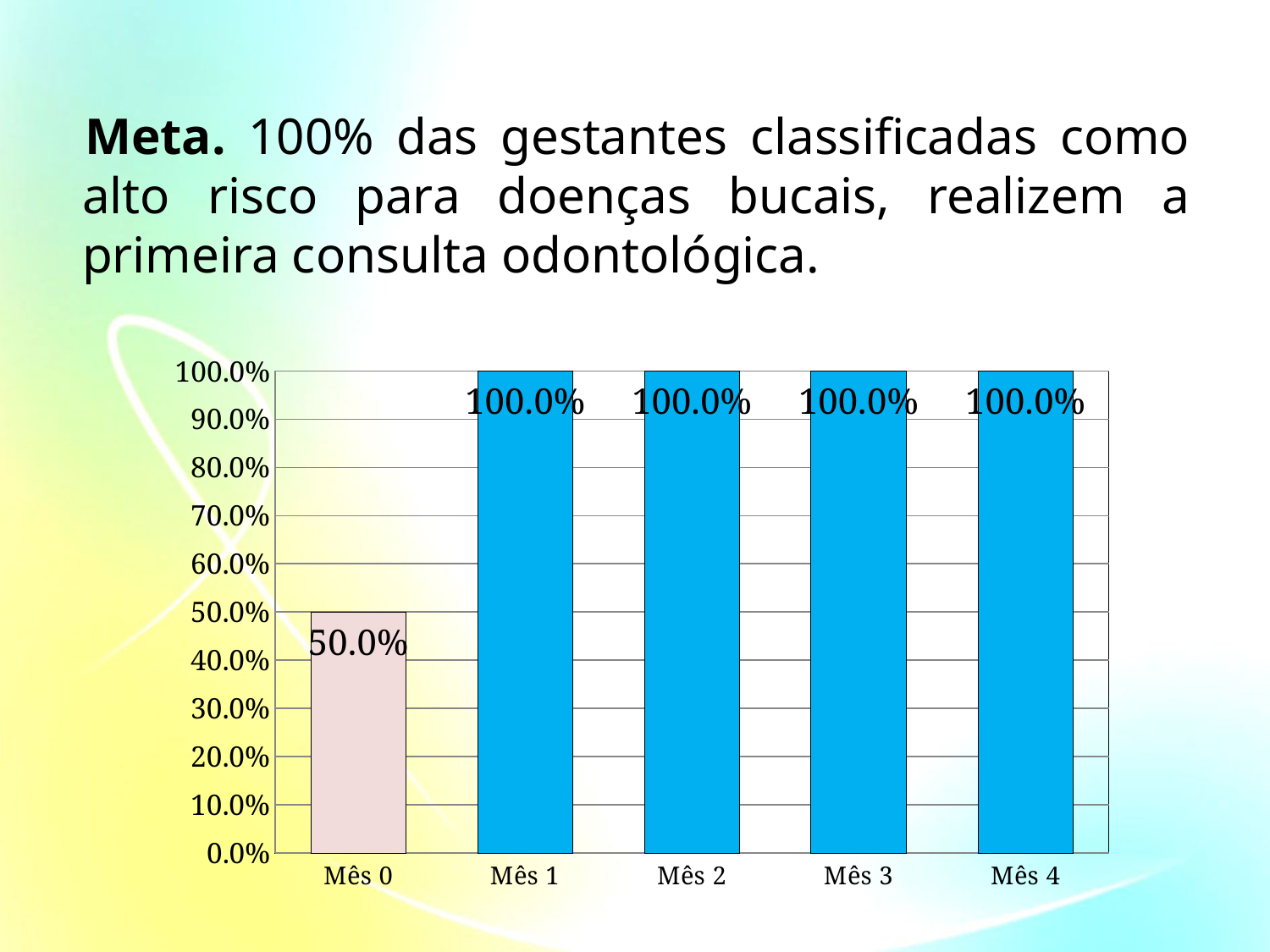
Which category has the lowest value? Mês 0 What is the value for Mês 4? 100.0% Is the value for Mês 0 greater or less than 60.0%? less What kind of chart is shown on the slide? bar chart Do the values rise or fall from Mês 0 to Mês 1? rise What is the value for Mês 0? 50.0% How many categories have a value of 100.0%? 4 What is the difference between the values for Mês 1 and Mês 0? 50.0% What colour is the bar for Mês 0? light pink What is the value for Mês 2? 100.0% Which is larger, the value for Mês 0 or the value for Mês 3? Mês 3 How many categories are shown on the x axis? 5